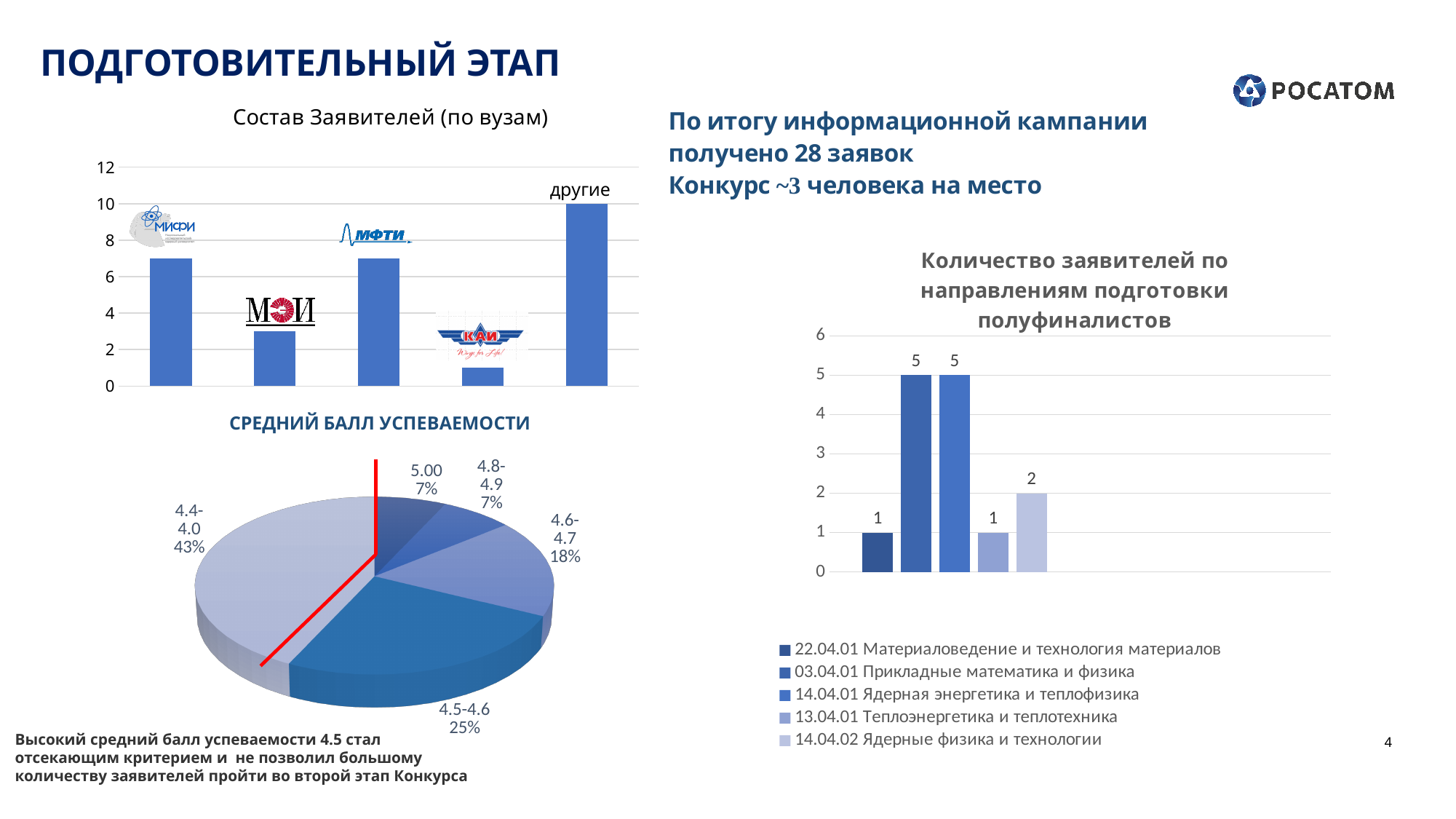
In the chart 'Состав Заявителей (по вузам)', is the value for the КАИ bar greater or less than 2? less In the chart 'Количество заявителей по направлениям подготовки полуфиналистов', what is the difference between the value for '03.04.01 Прикладные математика и физика' and the value for '22.04.01 Материаловедение и технология материалов'? 4 In the chart 'Состав Заявителей (по вузам)', what is the value for the 'другие' bar? 10 In the chart 'Количество заявителей по направлениям подготовки полуфиналистов', how many entries does the legend list? 5 In the chart 'Состав Заявителей (по вузам)', which category has the highest bar? другие In the chart 'СРЕДНИЙ БАЛЛ УСПЕВАЕМОСТИ', what share of the pie does the '4.4-4.0' slice have? 43% What kind of chart is 'СРЕДНИЙ БАЛЛ УСПЕВАЕМОСТИ'? pie chart In the chart 'СРЕДНИЙ БАЛЛ УСПЕВАЕМОСТИ', what share does the '4.5-4.6' slice have? 25% In the chart 'Количество заявителей по направлениям подготовки полуфиналистов', what is the value for '14.04.02 Ядерные физика и технологии'? 2 In the chart 'Состав Заявителей (по вузам)', how many bars are plotted? 5 In the chart 'СРЕДНИЙ БАЛЛ УСПЕВАЕМОСТИ', which slice is the largest? 4.4-4.0 In the chart 'Состав Заявителей (по вузам)', is the value for the МИФИ bar greater or less than 6? greater